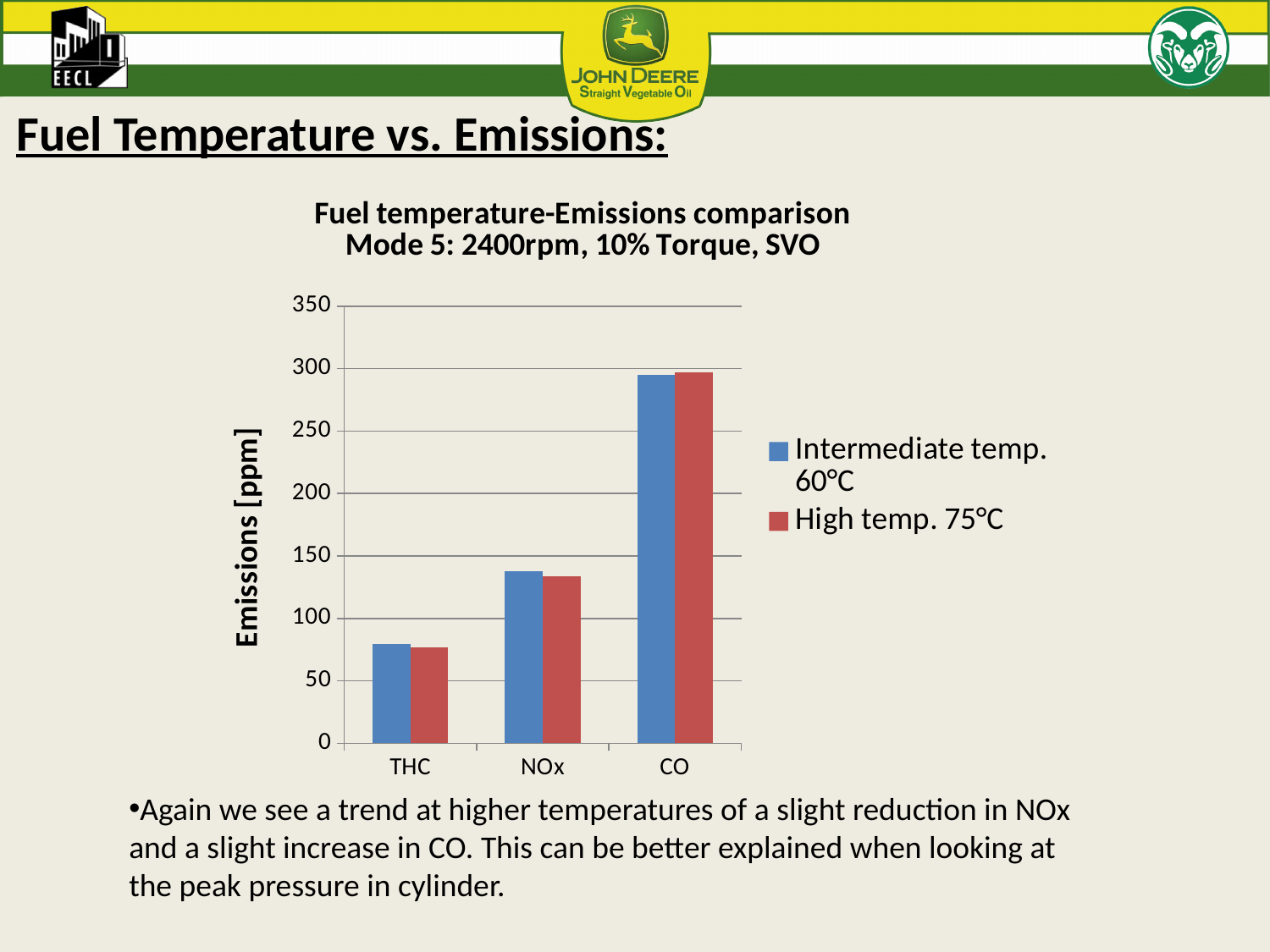
Is the value for CO at Intermediate temp. 60°C greater or less than 250? greater Which emission category has the lowest values? THC What is the label of the y axis? Emissions [ppm] How many emission categories are shown on the x axis? 3 Is the value for THC at High temp. 75°C greater or less than 100? less What kind of chart is shown on the slide? bar chart Which emission category has the highest values? CO Is the value for NOx at Intermediate temp. 60°C greater or less than 100? greater What are the two series named in the legend? Intermediate temp. 60°C and High temp. 75°C Which is larger, the CO value or the NOx value at High temp. 75°C? CO How many series does the legend list? 2